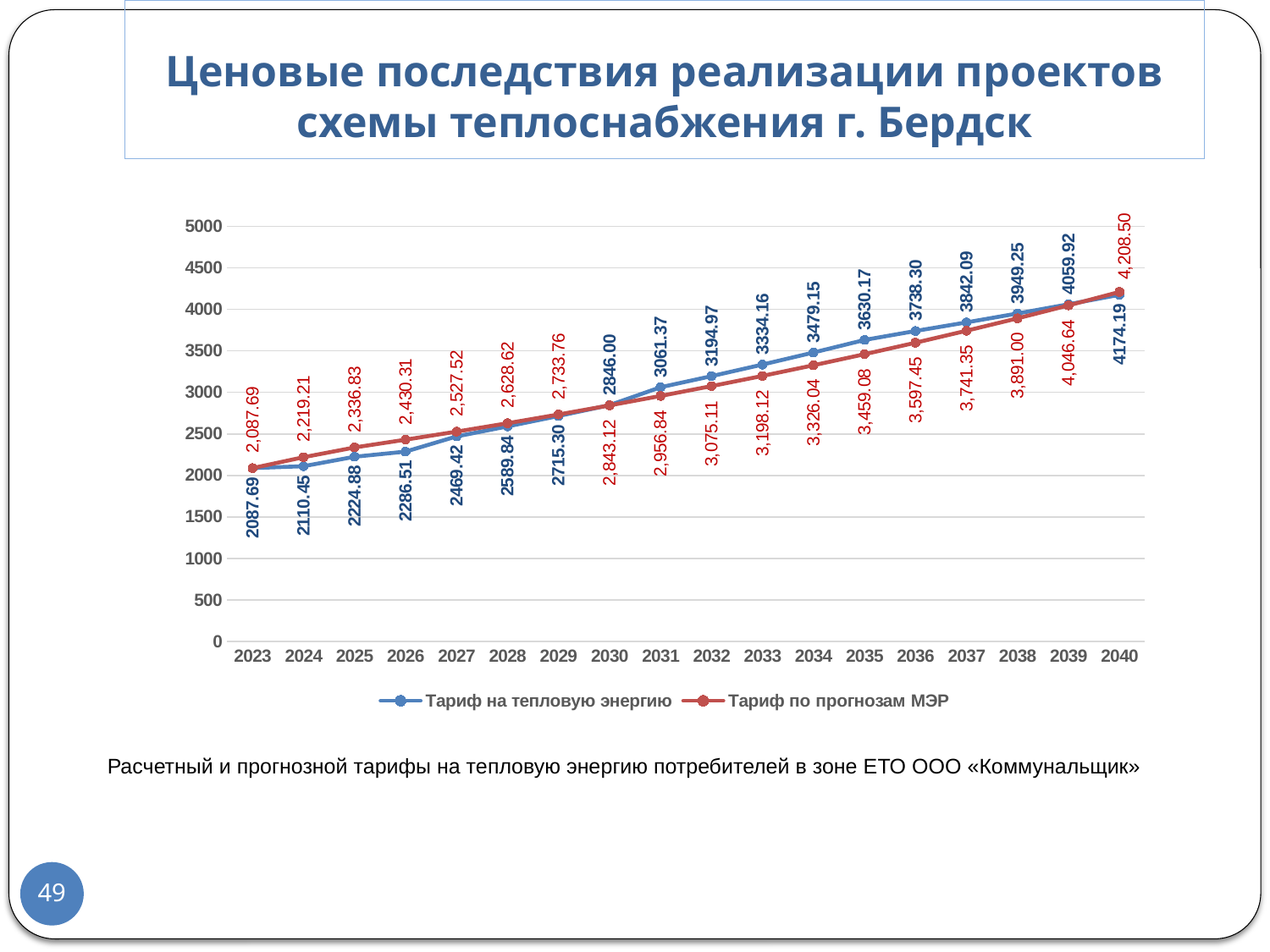
Which series has the larger value in 2034, "Тариф на тепловую энергию" or "Тариф по прогнозам МЭР"? Тариф на тепловую энергию What is the value of "Тариф на тепловую энергию" in 2030? 2846.00 What is the difference between "Тариф на тепловую энергию" and "Тариф по прогнозам МЭР" in 2040? 34.31 How many years are plotted along the x axis? 18 What is the value of "Тариф по прогнозам МЭР" in 2040? 4,208.50 Do the values of "Тариф по прогнозам МЭР" rise or fall from 2023 to 2040? rise In which year is "Тариф по прогнозам МЭР" lowest? 2023 How many series does the legend list? 2 In which year is "Тариф на тепловую энергию" highest? 2040 What is the value of "Тариф по прогнозам МЭР" in 2035? 3,459.08 What is the value of "Тариф на тепловую энергию" in 2023? 2087.69 What type of chart is shown on the slide? line chart